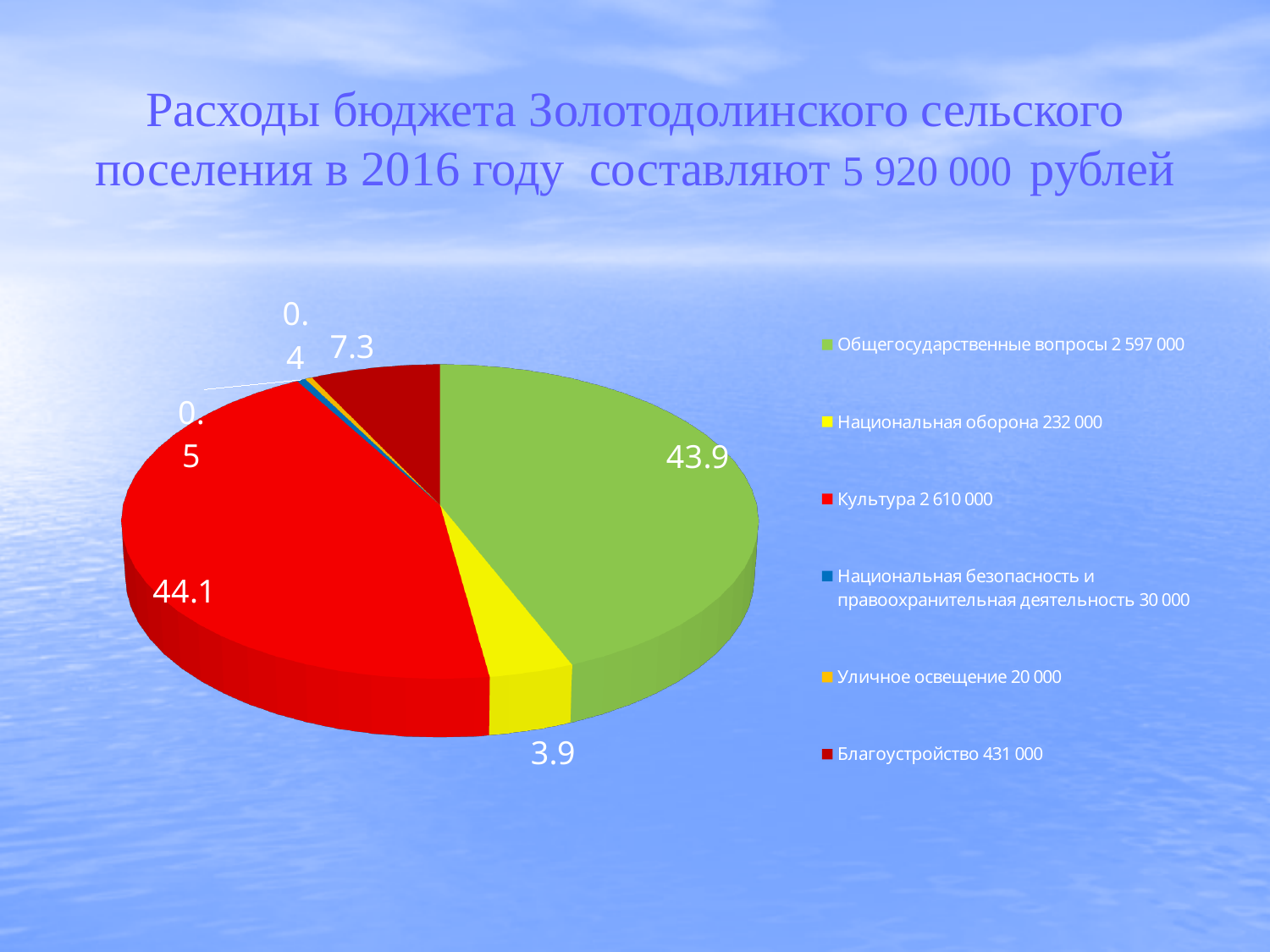
What kind of chart is shown on the slide? Pie chart What colour is the Культура slice? Red What amount does the legend give for Благоустройство? 431 000 What is the difference between the Культура share and the Общегосударственные вопросы share? 0.2 Which is larger, the Культура slice or the Общегосударственные вопросы slice? Культура How many categories does the pie chart have? 6 What percentage share does the Национальная оборона slice show? 3.9 What percentage share does the Культура slice show? 44.1 Which is larger, the Благоустройство slice or the Национальная оборона slice? Благоустройство What percentage share does the Благоустройство slice show? 7.3 Which category has the largest slice of the pie? Культура What percentage share does the Общегосударственные вопросы slice show? 43.9